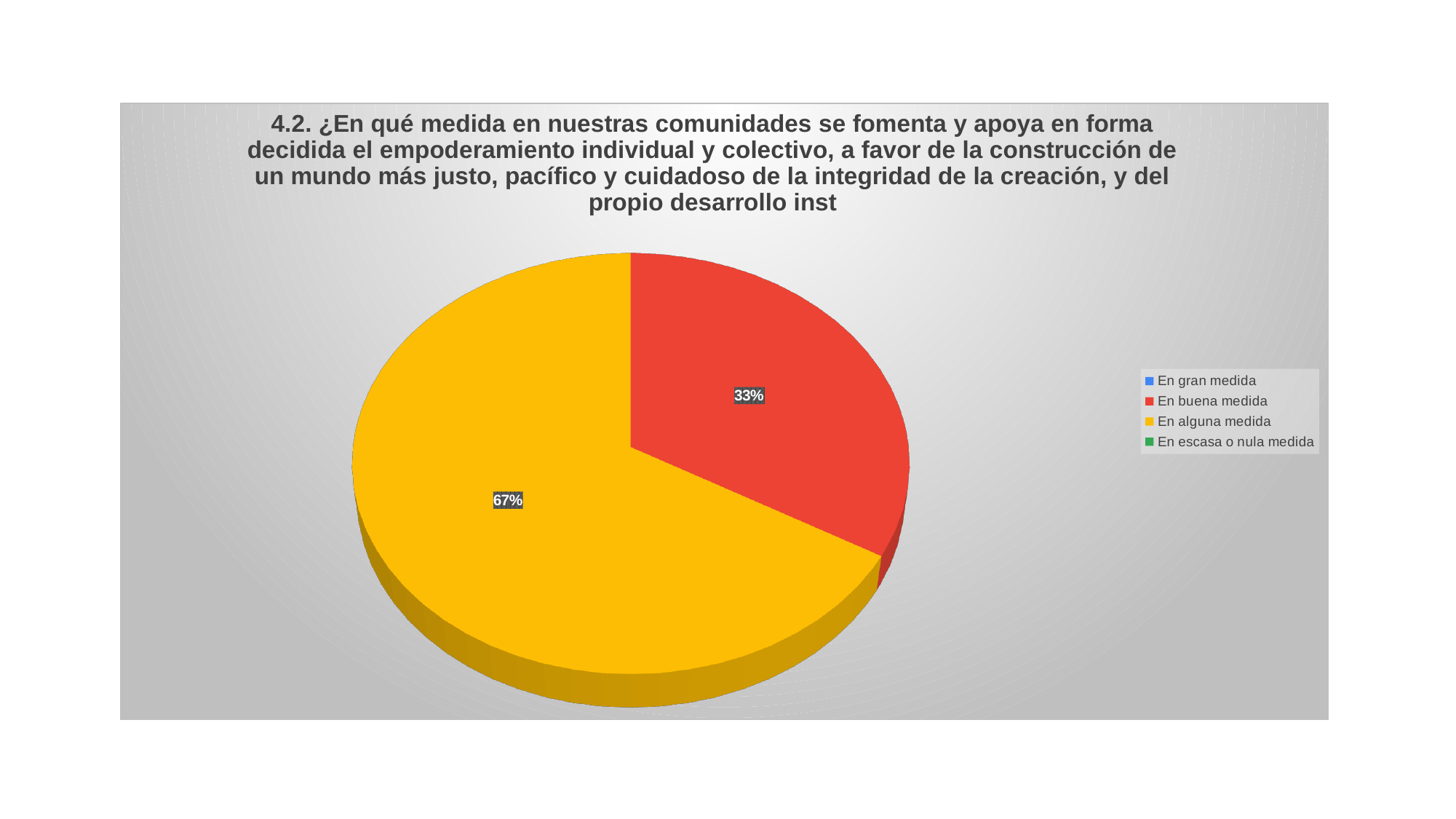
Which category has the largest slice of the pie? En alguna medida What is the difference in percentage points between the "En alguna medida" slice and the "En buena medida" slice? 34 What share of the pie does "En buena medida" have? 33% What kind of chart is shown on the slide? pie chart How many slices are visible in the pie? 2 How many categories does the legend list? 4 Which is larger, the slice for "En buena medida" or the slice for "En alguna medida"? En alguna medida What colour is the slice for "En alguna medida"? yellow What share of the pie does "En alguna medida" have? 67% Is the share for "En alguna medida" greater or less than 50%? greater What colour is the slice for "En buena medida"? red